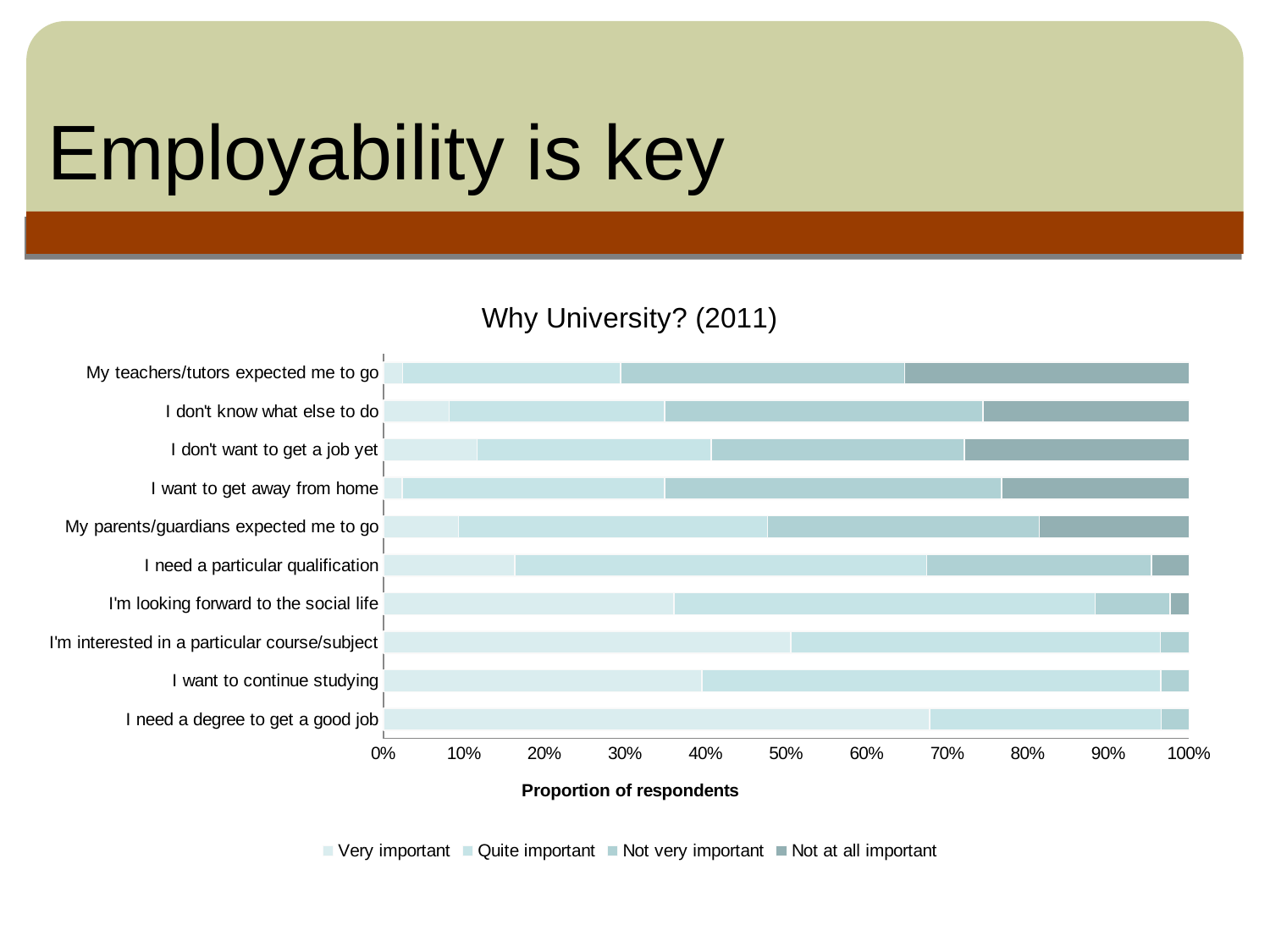
Which reason has the largest 'Not at all important' share? My teachers/tutors expected me to go Is the 'Very important' share for 'I'm looking forward to the social life' greater or less than 30%? greater How many series does the legend list? 4 What kind of chart is shown on the slide? Stacked bar chart What is the total of the stacked bar for 'I don't know what else to do'? 100% What is the title of the chart? Why University? (2011) How many reasons (categories) are plotted on the chart? 10 Which has the larger 'Very important' share: 'I want to continue studying' or 'I need a particular qualification'? I want to continue studying Is the 'Very important' share for 'I need a degree to get a good job' greater or less than 60%? greater Which reason has the largest 'Very important' share? I need a degree to get a good job Is the 'Very important' share for 'My parents/guardians expected me to go' greater or less than 20%? less What is the label of the horizontal axis? Proportion of respondents